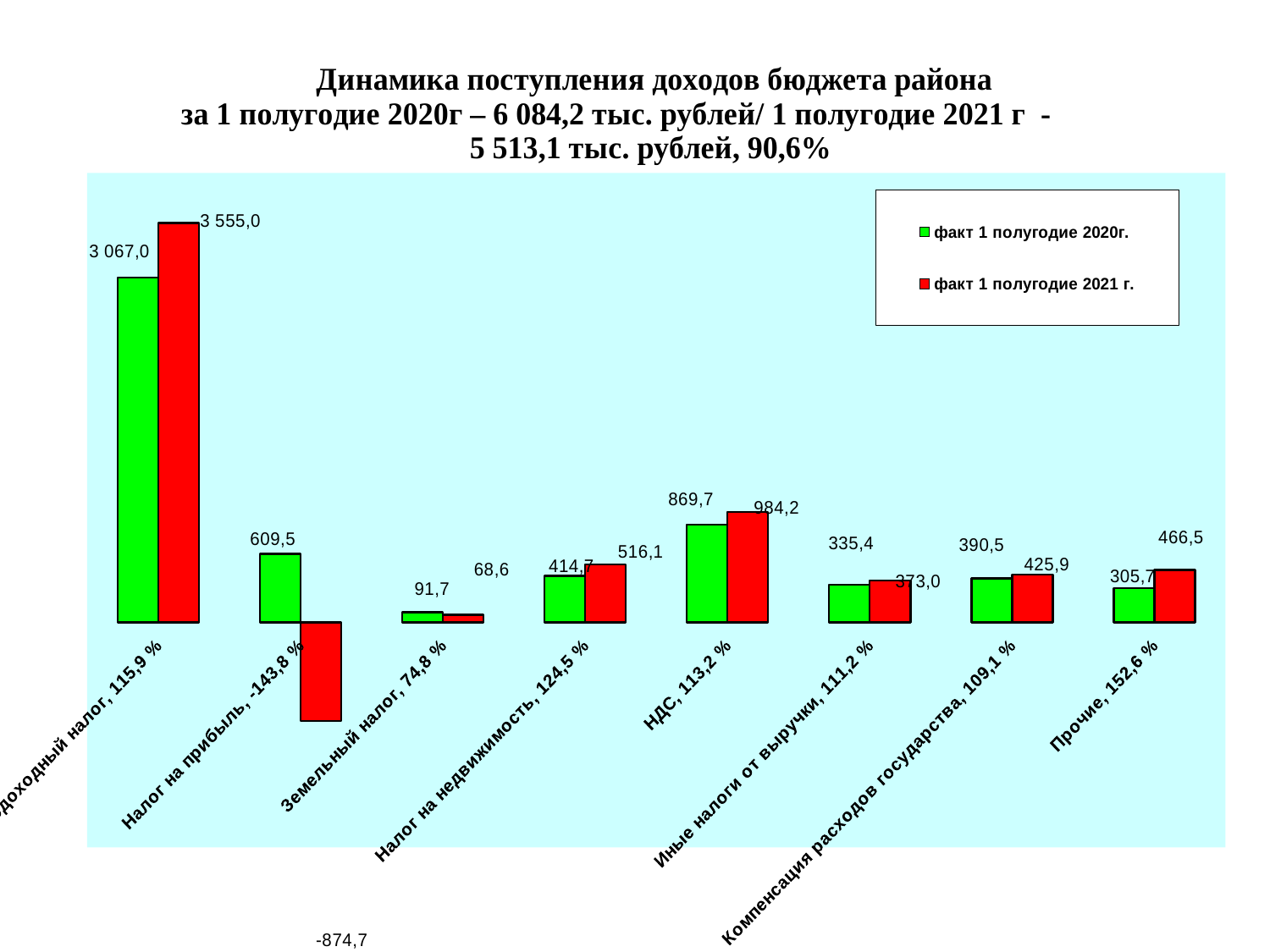
What is the value for Прочие in the series 'факт 1 полугодие 2021 г.'? 466,5 Which category has the highest value in the series 'факт 1 полугодие 2020г.'? Подоходный налог What is the difference between the 2021 and 2020 values for Налог на недвижимость? 101,4 What type of chart is shown on the slide? bar chart What is the value for Налог на прибыль in the series 'факт 1 полугодие 2020г.'? 609,5 Which category has the lowest value in the series 'факт 1 полугодие 2021 г.'? Налог на прибыль For Земельный налог, which series has the larger value: 'факт 1 полугодие 2020г.' or 'факт 1 полугодие 2021 г.'? факт 1 полугодие 2020г. What is the value for Земельный налог in the series 'факт 1 полугодие 2020г.'? 91,7 What is the value for НДС in the series 'факт 1 полугодие 2021 г.'? 984,2 How many categories are shown on the x axis of the chart? 8 What colour are the bars for the series 'факт 1 полугодие 2021 г.'? red How many series does the legend list? 2